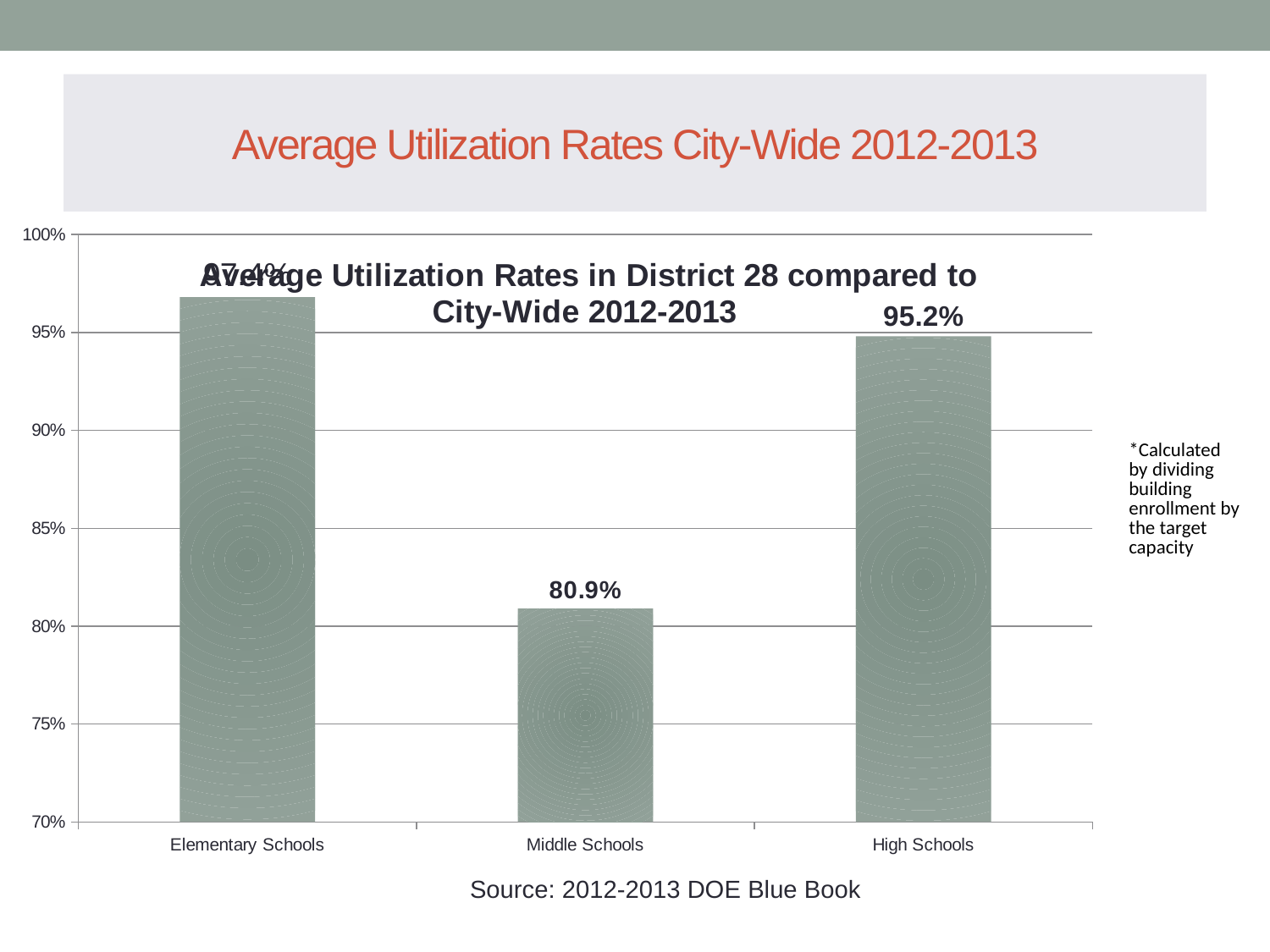
Which school type has the highest average utilization rate? Elementary Schools Which has a higher utilization rate, Middle Schools or High Schools? High Schools What is the average utilization rate for High Schools? 95.2% What kind of chart is shown on the slide? Bar chart Is the value for Middle Schools greater or less than 85%? less What source is cited below the chart? 2012-2013 DOE Blue Book Which school type has the lowest average utilization rate? Middle Schools Is the value for Elementary Schools greater or less than 95%? greater What is the highest value shown on the vertical axis? 100% What is the average utilization rate for Middle Schools? 80.9% How many percentage points higher is the High Schools rate than the Middle Schools rate? 14.3 percentage points How many school types are shown on the chart? 3